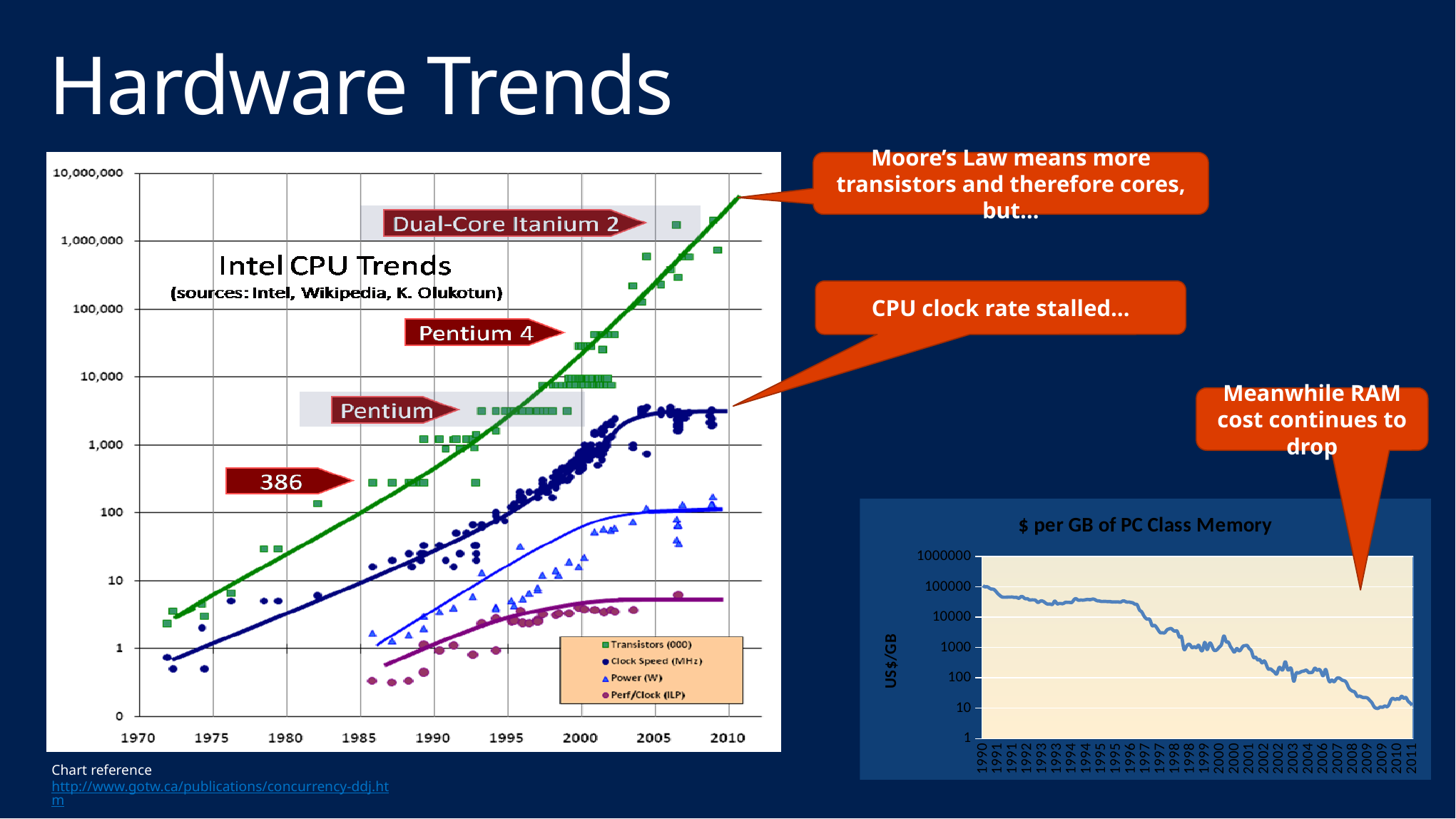
What kind of chart is the $ per GB of PC Class Memory chart? line chart On the Intel CPU Trends chart, which series is plotted with green squares? Transistors (000) On the Intel CPU Trends chart, how many series does the legend list? 4 On the $ per GB of PC Class Memory chart, do the values rise or fall from 1990 to 2011? fall On the $ per GB of PC Class Memory chart, is the value in 1990 greater or less than 10000? greater On the $ per GB of PC Class Memory chart, is the value in 2011 greater or less than 100? less On the Intel CPU Trends chart, which series has the highest values around 2005: Transistors (000) or Perf/Clock (ILP)? Transistors (000) On the Intel CPU Trends chart, is the Clock Speed (MHz) value around 2005 greater or less than 1,000? greater What is the title of the chart on the right of the slide? $ per GB of PC Class Memory On the Intel CPU Trends chart, do the Transistors (000) values rise or fall from 1970 to 2010? rise